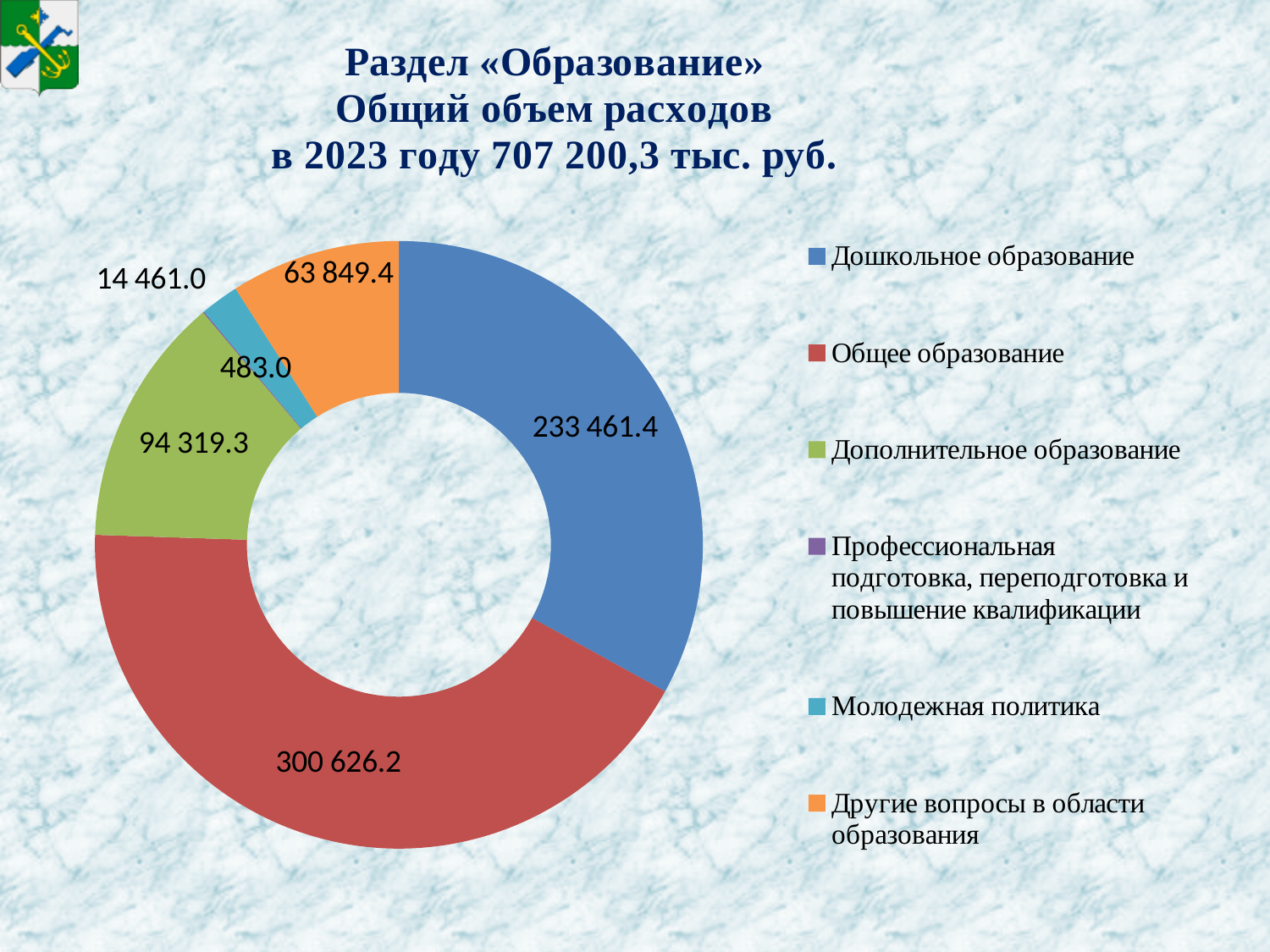
How many categories does the chart show? 6 What kind of chart is shown on the slide? doughnut chart What is the difference between Общее образование and Дошкольное образование? 67 164.8 What is the value for Общее образование? 300 626.2 Which is larger, Дополнительное образование or Другие вопросы в области образования? Дополнительное образование What is the value for Молодежная политика? 14 461.0 What is the value for Дошкольное образование? 233 461.4 Which category has the largest value? Общее образование What is the value for Дополнительное образование? 94 319.3 Which category has the smallest value? Профессиональная подготовка, переподготовка и повышение квалификации What colour is the segment for Общее образование? red What is the value for Другие вопросы в области образования? 63 849.4